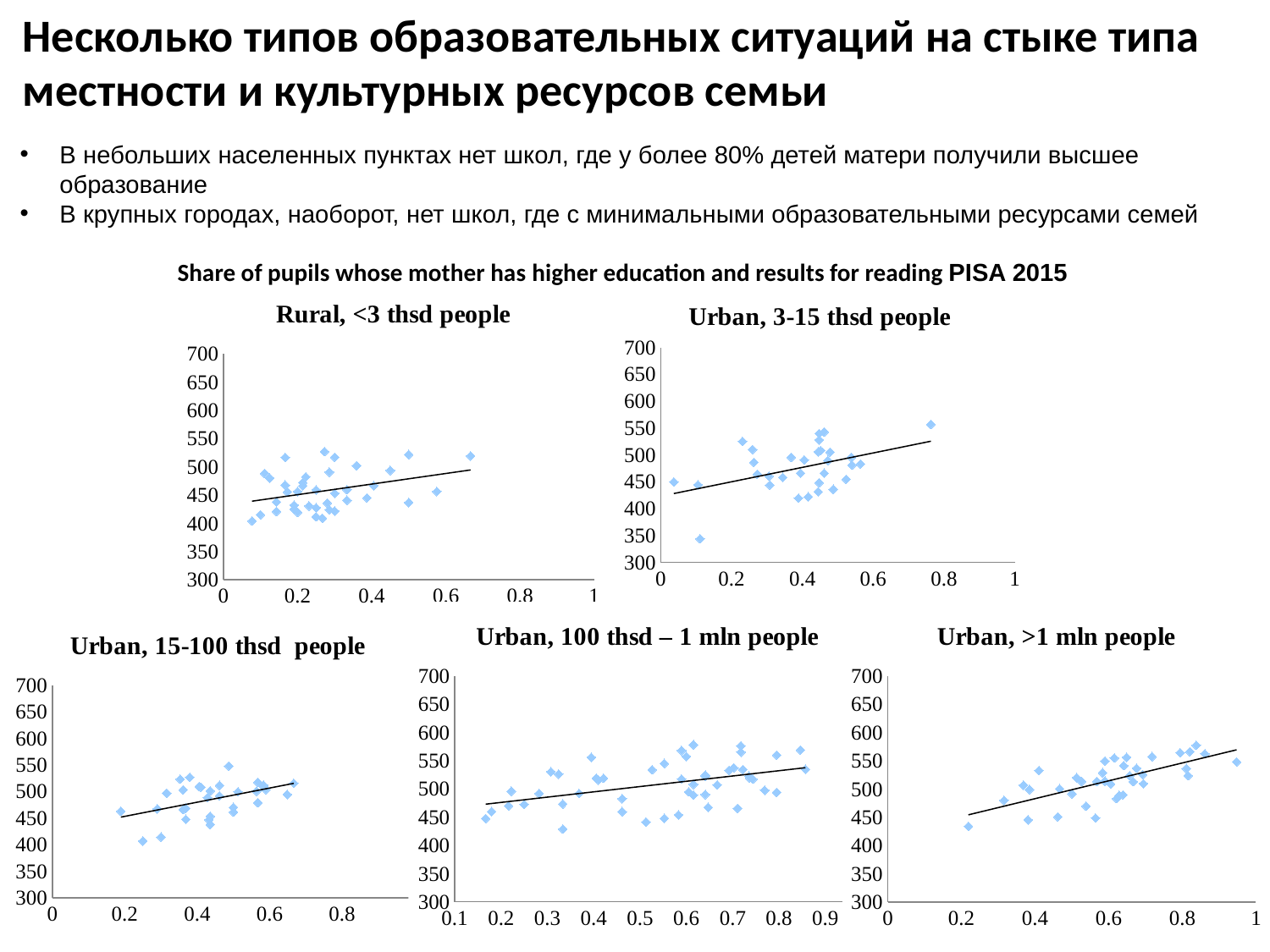
In the 'Rural, <3 thsd people' chart, is the highest plotted point greater or less than 600? less How many charts are shown on the slide? 5 What is the common title given above the group of charts? Share of pupils whose mother has higher education and results for reading PISA 2015 What is the range of the y axis on the 'Urban, 3-15 thsd people' chart? 300 to 700 In the 'Urban, 15-100 thsd people' chart, is the lowest plotted point greater or less than 450? less In the 'Urban, >1 mln people' chart, do the reading results tend to rise or fall as the share of pupils whose mother has higher education increases? rise In the 'Urban, 100 thsd – 1 mln people' chart, does the trend line rise or fall from left to right? rise In the 'Urban, 100 thsd – 1 mln people' chart, is the highest plotted point greater or less than 550? greater In the 'Rural, <3 thsd people' chart, does the fitted trend line rise or fall along the x axis? rise What kind of chart is the 'Rural, <3 thsd people' chart? scatter chart